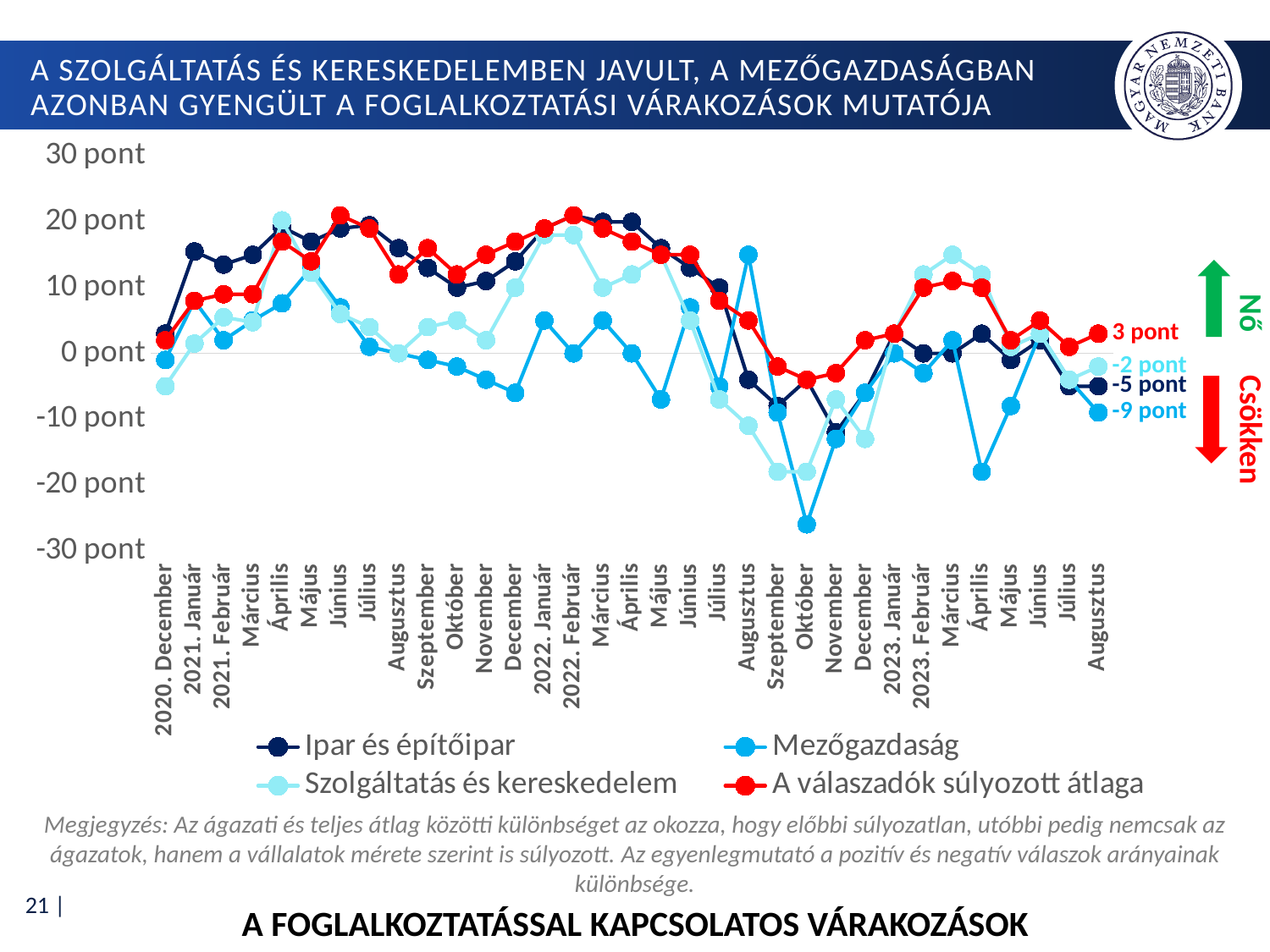
What is the value of 'Mezőgazdaság' for 2023 Augusztus? -9 pont What is the value of 'Szolgáltatás és kereskedelem' for 2023 Augusztus? -2 pont In 2023 Augusztus, which is higher: 'Ipar és építőipar' or 'Mezőgazdaság'? Ipar és építőipar What is the value of 'Ipar és építőipar' for 2023 Augusztus? -5 pont Is the value for 'Ipar és építőipar' in 2021 Január greater or less than 10 pont? greater What kind of chart is shown on the slide? line chart Is the value for 'Mezőgazdaság' in 2022 Október greater or less than -20 pont? less Which series is drawn in red? A válaszadók súlyozott átlaga In 2023 Augusztus, what is the difference between 'A válaszadók súlyozott átlaga' and 'Mezőgazdaság'? 12 pont Which series has the lowest value in 2023 Augusztus? Mezőgazdaság What is the value of 'A válaszadók súlyozott átlaga' for 2023 Augusztus? 3 pont How many series does the legend list? 4